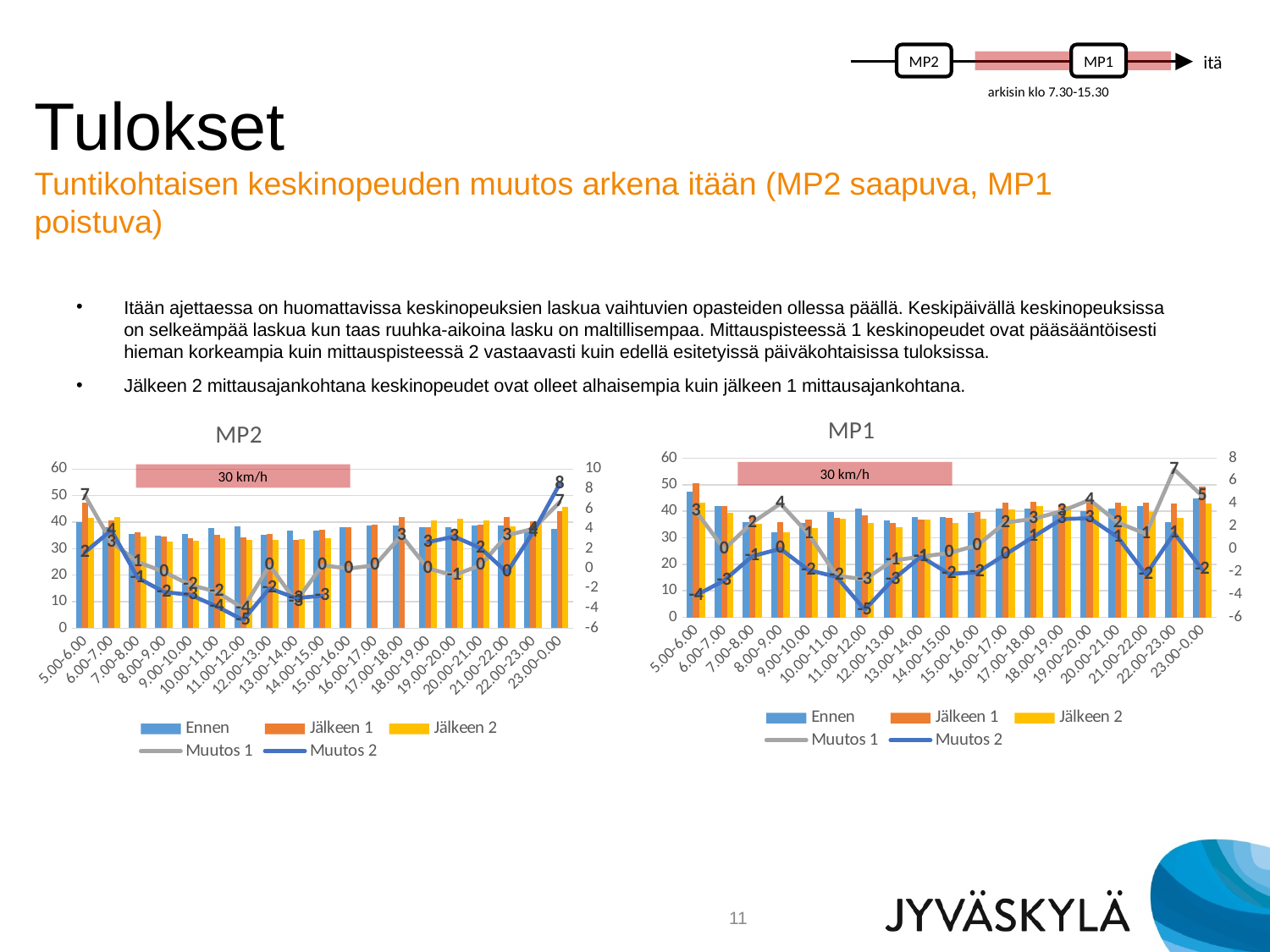
On the MP1 chart, what is the Muutos 2 value for 5.00-6.00? -4 How many hourly categories are shown on the x axis of the MP2 chart? 19 On the MP2 chart, what is the Muutos 2 value for 23.00-0.00? 8 On the MP1 chart, what is the Muutos 1 value for 22.00-23.00? 7 On the MP2 chart, in which hour is the Muutos 2 line at its lowest? 11.00-12.00 On the MP1 chart, is the Jälkeen 1 bar for 5.00-6.00 greater or less than 40? greater On the MP2 chart, what is the Muutos 1 value for 5.00-6.00? 7 On the MP1 chart, at 23.00-0.00, which is larger: Muutos 1 or Muutos 2? Muutos 1 What speed is written in the red box on the MP2 chart? 30 km/h How many series does the legend of the MP1 chart list? 5 On the MP1 chart, in which hour does the Muutos 1 line reach its highest value? 22.00-23.00 On the MP2 chart, what is the difference between Muutos 1 and Muutos 2 at 5.00-6.00? 5